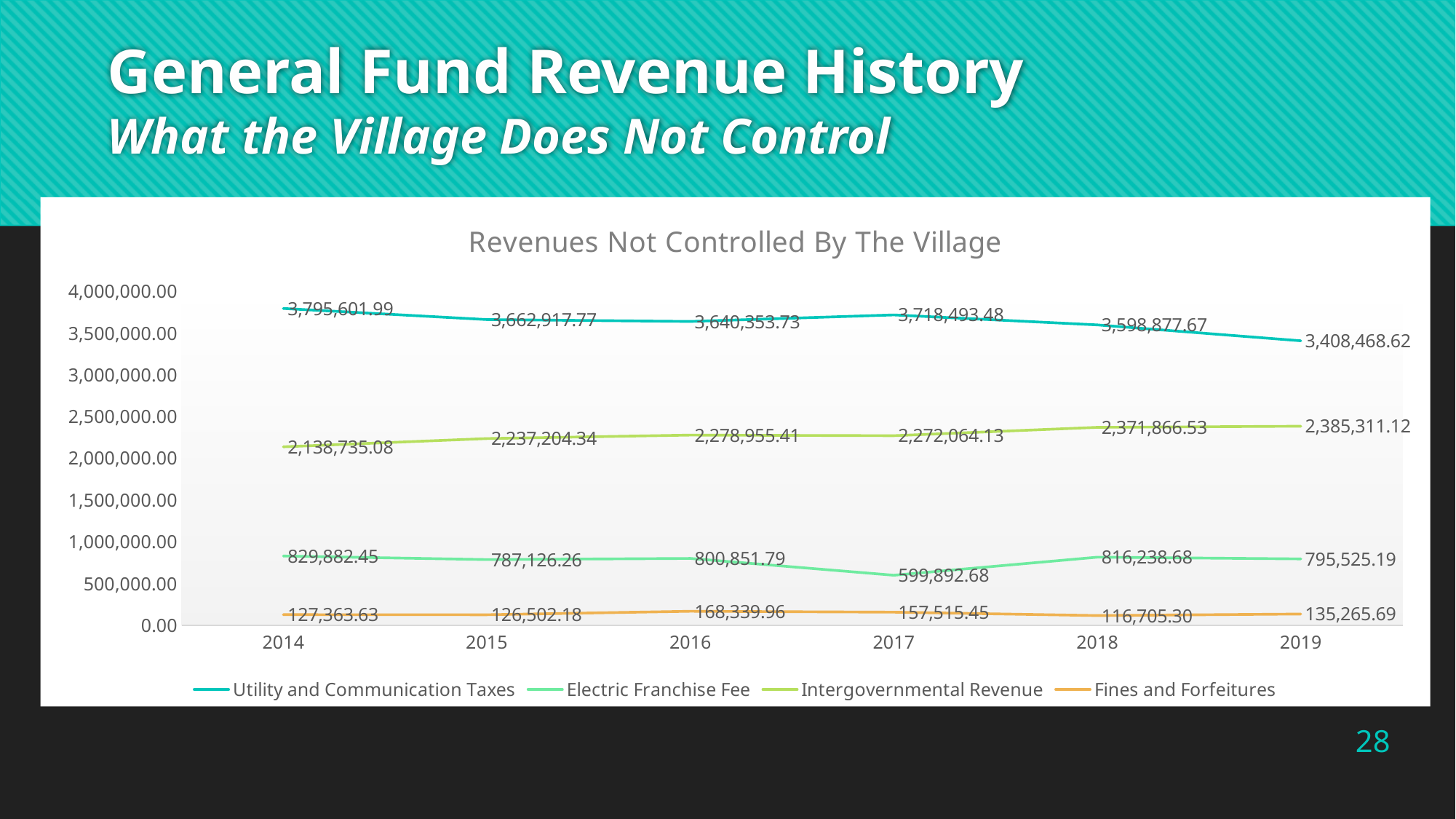
How many years are shown on the x axis? 6 What is the value of Intergovernmental Revenue in 2019? 2,385,311.12 In which year is Fines and Forfeitures lowest? 2018 What is the difference between Utility and Communication Taxes in 2014 and in 2019? 387,133.37 What is the value of Electric Franchise Fee in 2017? 599,892.68 How many series does the legend list? 4 In which year is Electric Franchise Fee lowest? 2017 Does Utility and Communication Taxes rise or fall overall from 2014 to 2019? Fall Which is larger: Intergovernmental Revenue in 2018 or in 2019? 2019 In which year is Fines and Forfeitures highest? 2016 What is the value of Utility and Communication Taxes in 2014? 3,795,601.99 What kind of chart is this? Line chart